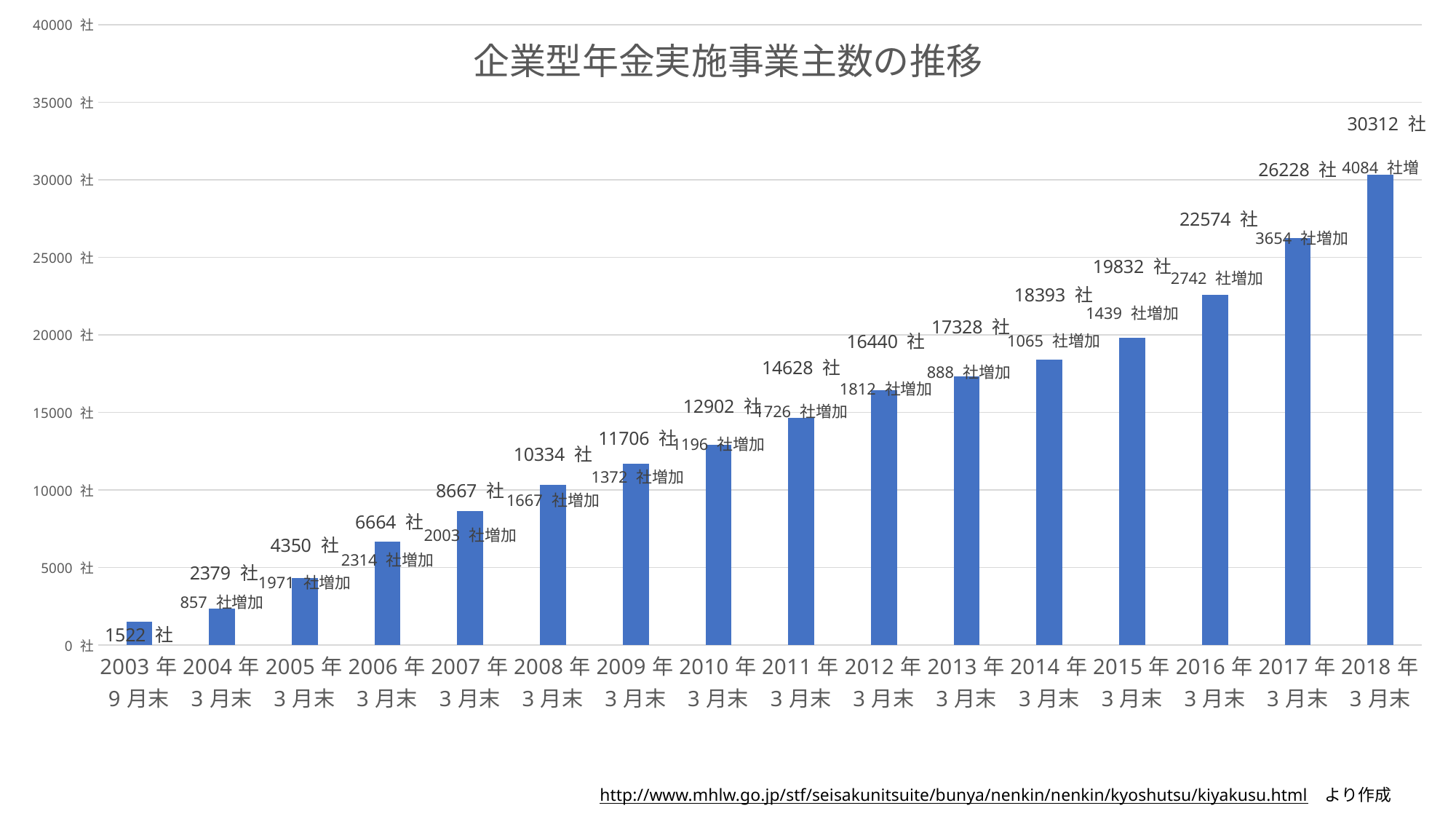
What kind of chart is this? bar chart What is the difference between the values for 2008年3月末 and 2007年3月末? 1667 社 Is the value for 2016年3月末 greater or less than 20000? greater What is the value for 2003年9月末? 1522 社 How many bars are shown in the chart? 16 Which category has the highest value? 2018年3月末 What is the value for 2018年3月末? 30312 社 Which category has the lowest value? 2003年9月末 Do the values rise or fall from 2003年9月末 to 2018年3月末? rise What is the difference between the values for 2018年3月末 and 2017年3月末? 4084 社 What is the value for 2010年3月末? 12902 社 Which is larger, the value for 2012年3月末 or the value for 2013年3月末? 2013年3月末